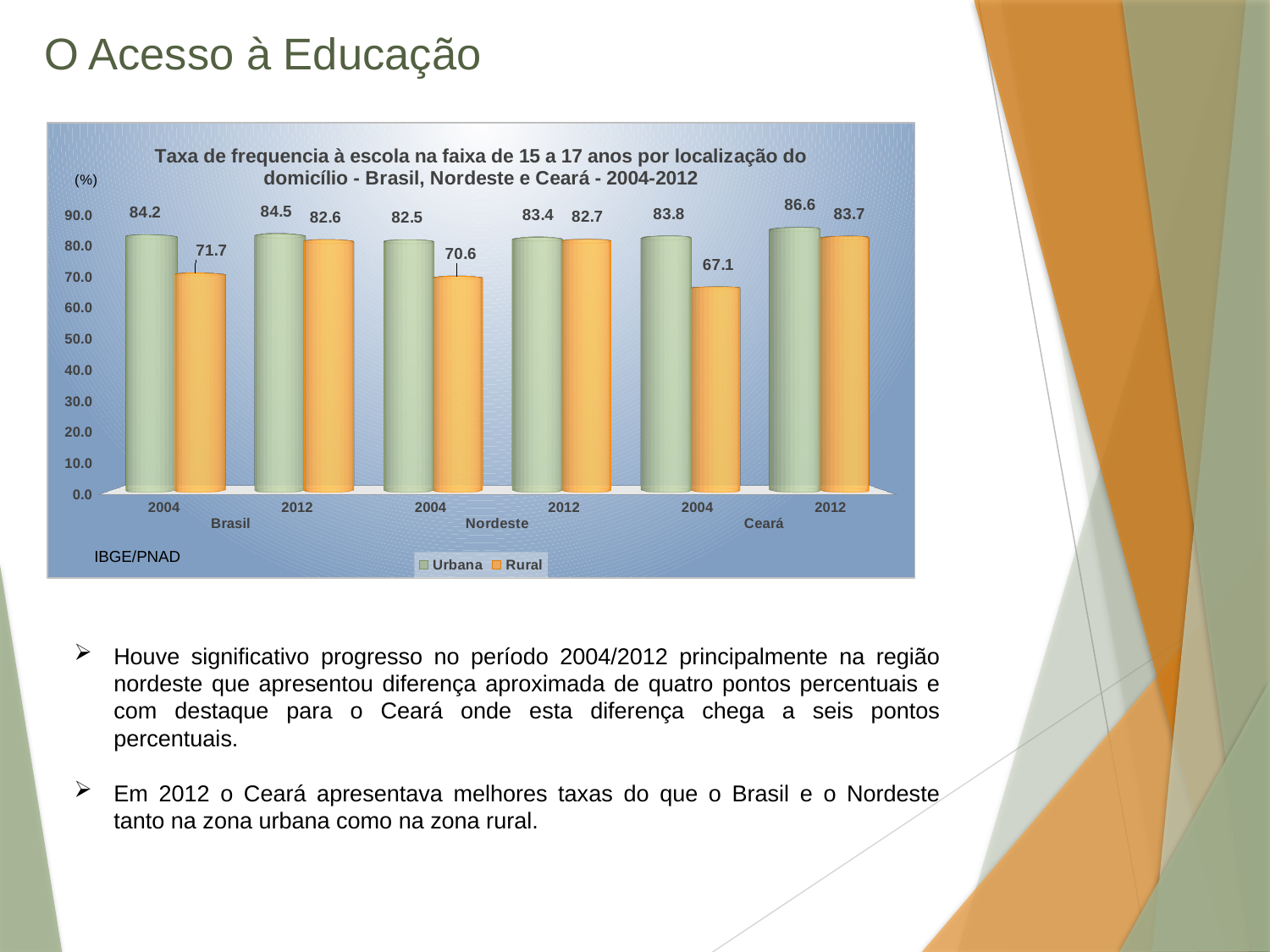
What is the difference between the Urbana and Rural values for Nordeste in 2004? 11.9 How many bars are plotted in the chart? 12 What is the difference between the Rural values for Ceará in 2012 and 2004? 16.6 What is the Urbana value for Brasil in 2004? 84.2 What source is cited below the chart? IBGE/PNAD What is the Rural value for Nordeste in 2012? 82.7 Which is larger, the Rural value for Brasil in 2004 or the Rural value for Nordeste in 2004? Brasil 2004 How many series does the legend list? 2 Which region and year has the lowest Rural value? Ceará 2004 Which region and year has the highest Urbana value? Ceará 2012 What is the Rural value for Ceará in 2004? 67.1 What kind of chart is shown? Bar chart